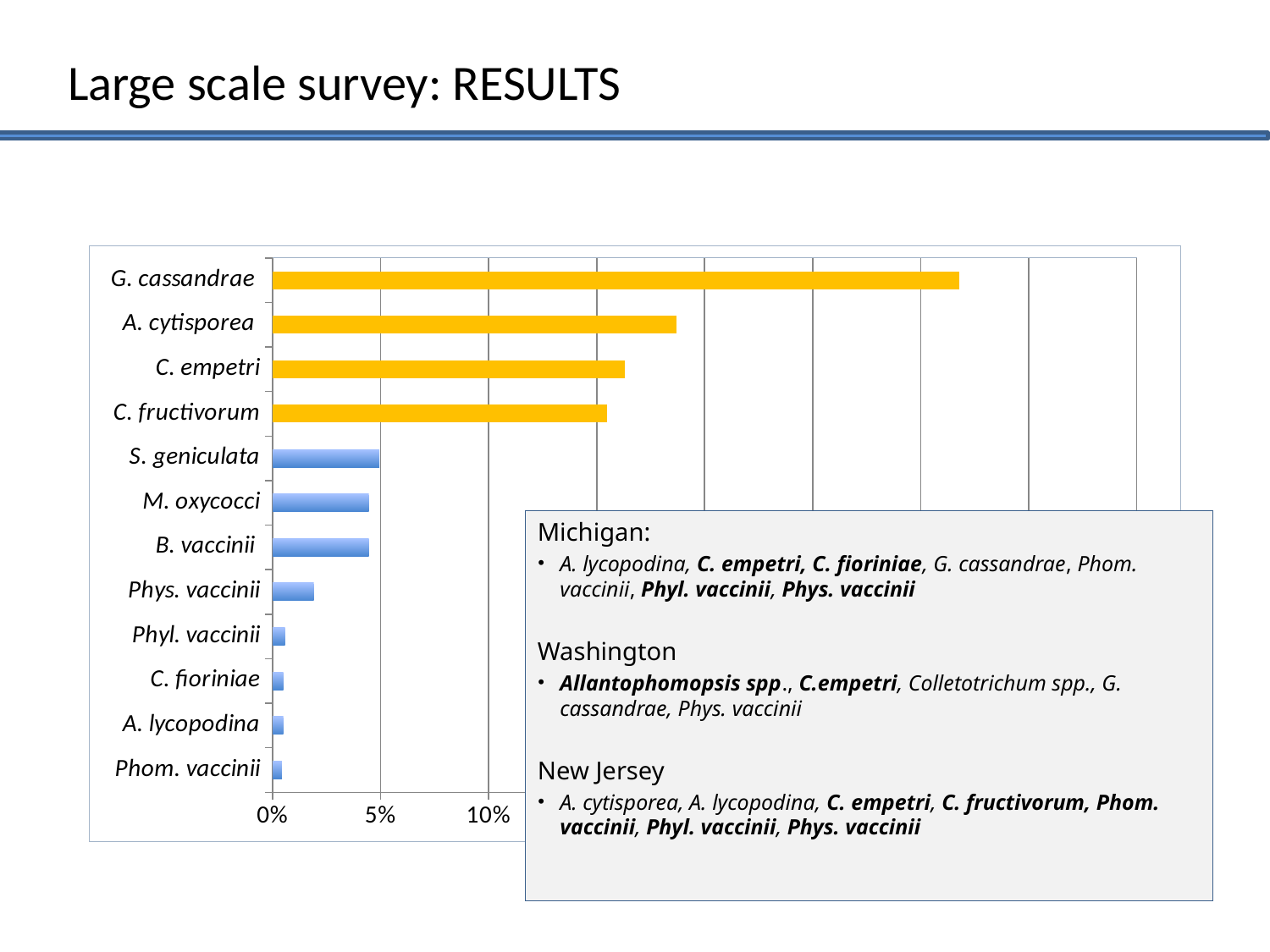
How many bars in the chart are coloured orange rather than blue? 4 Is the value for G. cassandrae greater or less than 10%? greater Which has the larger value, G. cassandrae or A. cytisporea? G. cassandrae Is the value for A. cytisporea greater or less than 10%? greater Is the value for C. fructivorum greater or less than 10%? greater What kind of chart is shown on the slide? bar chart Which has the larger value, C. fructivorum or S. geniculata? C. fructivorum How many species categories are plotted in the chart? 12 Which species is listed at the top of the chart's category axis? G. cassandrae Which species has the highest value in the chart? G. cassandrae